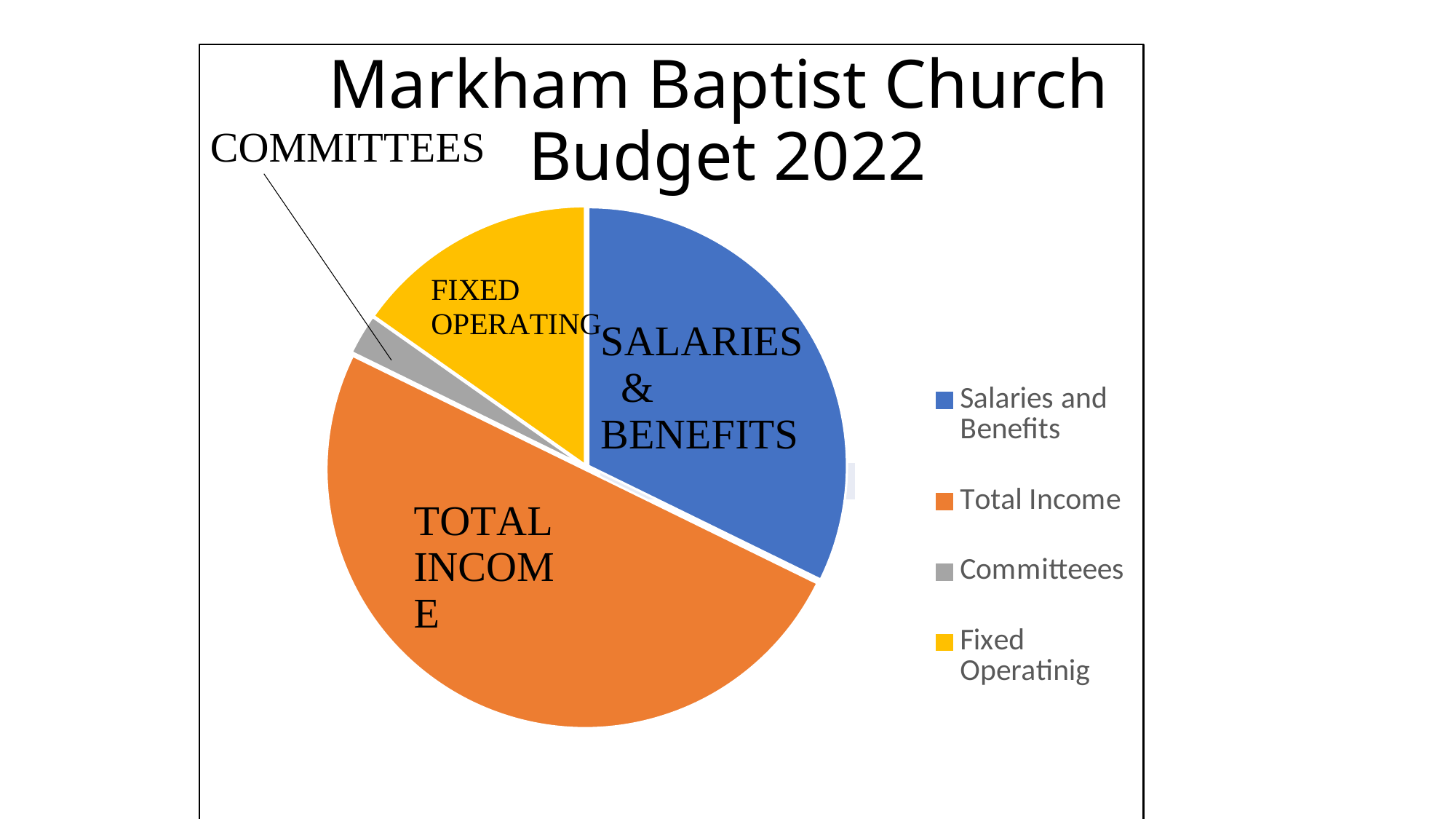
What colour is the Total Income slice in the pie chart? orange Which slice of the pie chart is the smallest? Committees Which slice of the pie chart is the largest? Total Income Which slice is larger, Total Income or Salaries & Benefits? Total Income Which slice is smaller, Total Income or Fixed Operating? Fixed Operating Which slice is larger, Salaries & Benefits or Fixed Operating? Salaries & Benefits How many slices does the pie chart have? 4 What is the title of the chart? Markham Baptist Church Budget 2022 What kind of chart is shown on the slide? pie chart How many entries does the legend list? 4